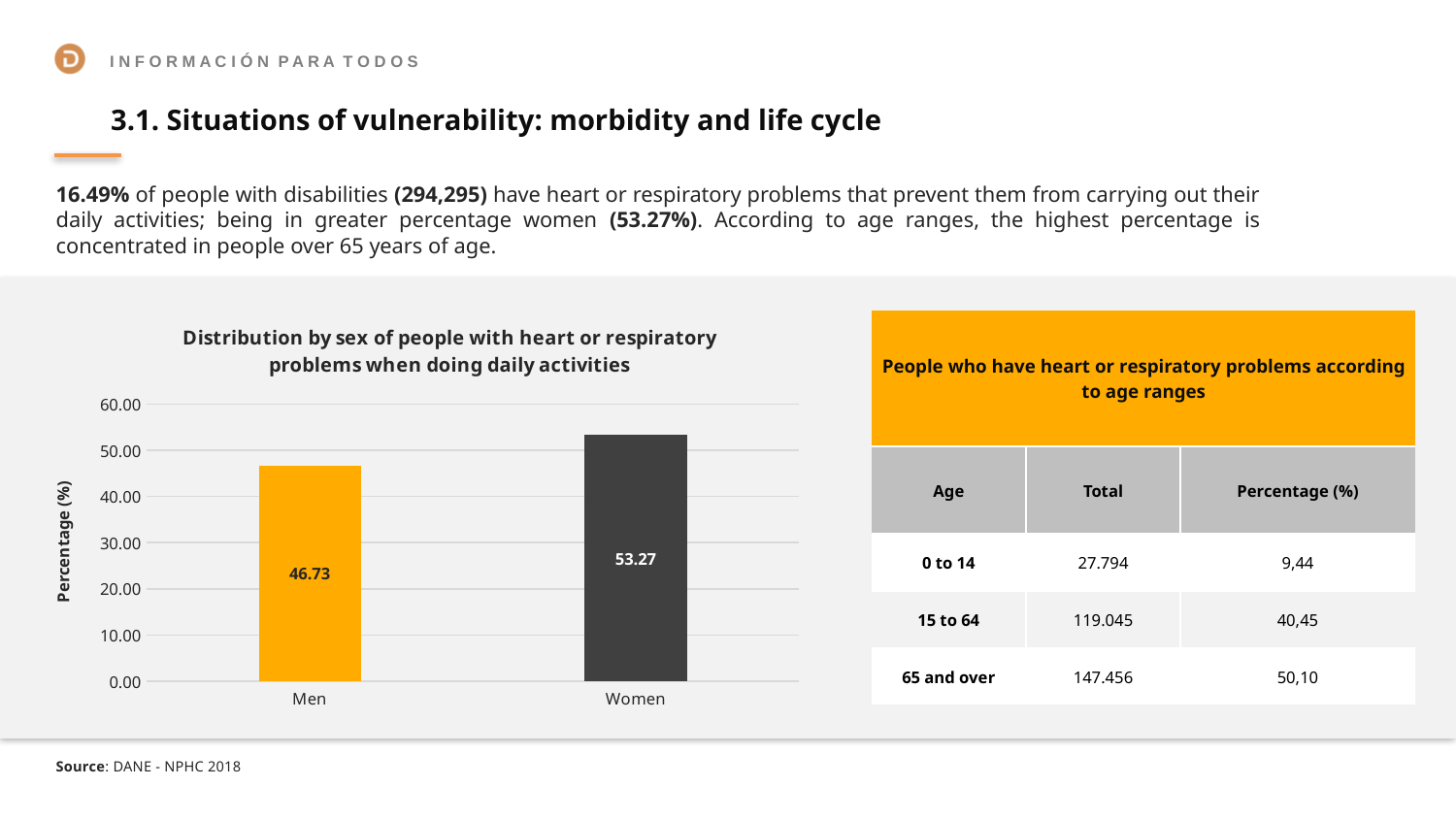
In the chart 'Distribution by sex of people with heart or respiratory problems when doing daily activities', what is the value for Men? 46.73 In the bar chart on the left, is the value for Women greater or less than 50.00? greater In the chart 'Distribution by sex of people with heart or respiratory problems when doing daily activities', what is the value for Women? 53.27 What is the label of the vertical axis of the bar chart on the left? Percentage (%) In the bar chart on the left, which category has the highest value? Women What kind of chart is shown on the left of the slide? bar chart In the bar chart on the left, what is the difference between the values for Women and Men? 6.54 In the bar chart on the left, which category has the lowest value? Men In the bar chart on the left, is the value for Men greater or less than 50.00? less In the bar chart on the left, which is larger: the value for Men or the value for Women? Women How many categories are shown on the x axis of the bar chart on the left? 2 What is the title of the bar chart on the left of the slide? Distribution by sex of people with heart or respiratory problems when doing daily activities